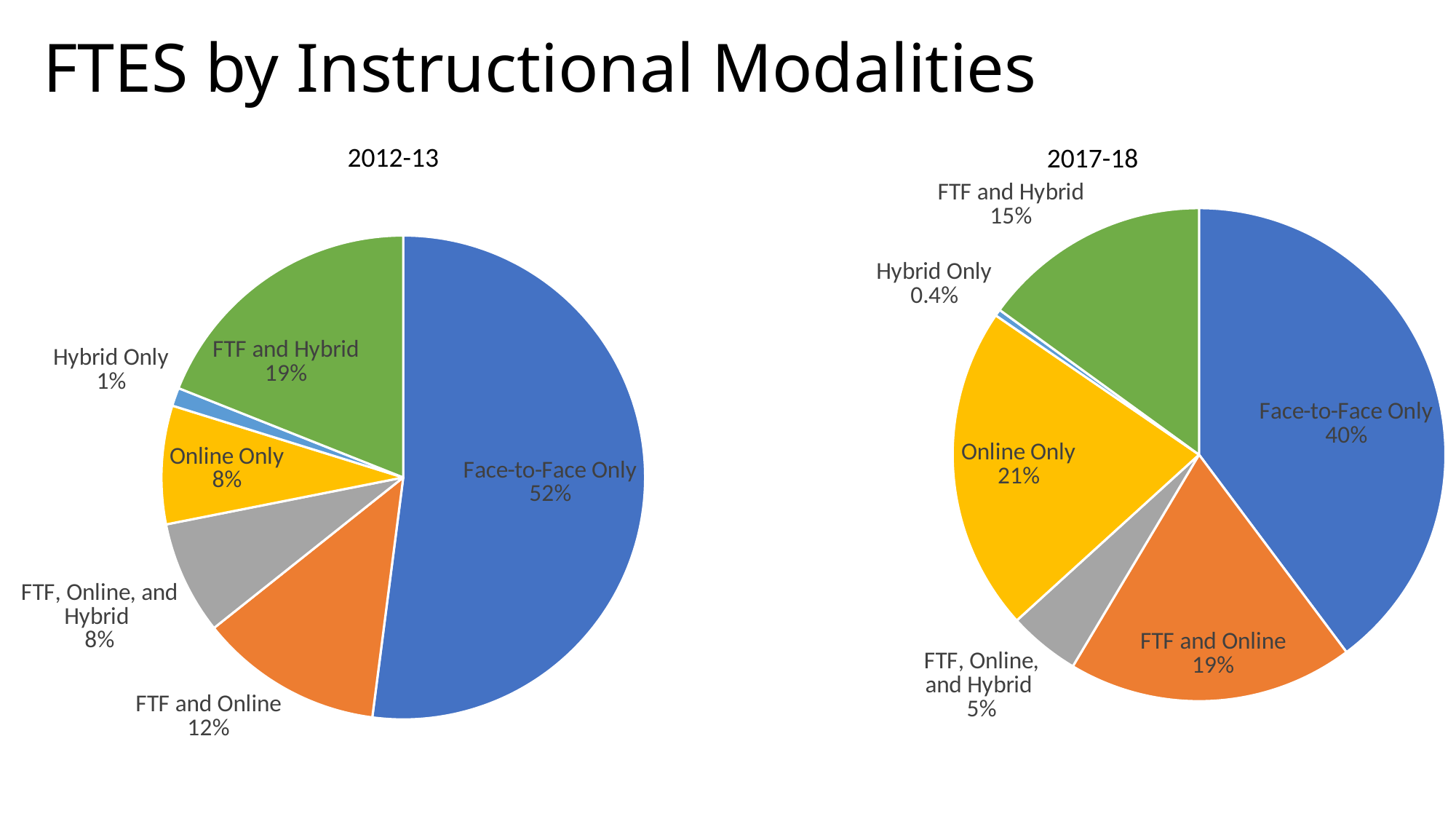
In the 2012-13 chart, which is larger: FTF and Hybrid or FTF and Online? FTF and Hybrid In the 2017-18 chart, what is the value for Hybrid Only? 0.4% In the 2012-13 chart, which modality has the largest slice? Face-to-Face Only In the 2017-18 chart, what is the difference between Face-to-Face Only and Online Only? 19% In the 2012-13 chart, what is the value for FTF and Online? 12% In the 2012-13 chart, what share of FTES is Face-to-Face Only? 52% What is the title of the slide? FTES by Instructional Modalities In the 2017-18 chart, what share of FTES is Online Only? 21% What kind of chart is the 2012-13 chart? Pie chart In the 2012-13 chart, what is the combined share of Online Only and FTF, Online, and Hybrid? 16% How many slices does the 2017-18 pie chart have? 6 In the 2017-18 chart, which modality has the smallest slice? Hybrid Only